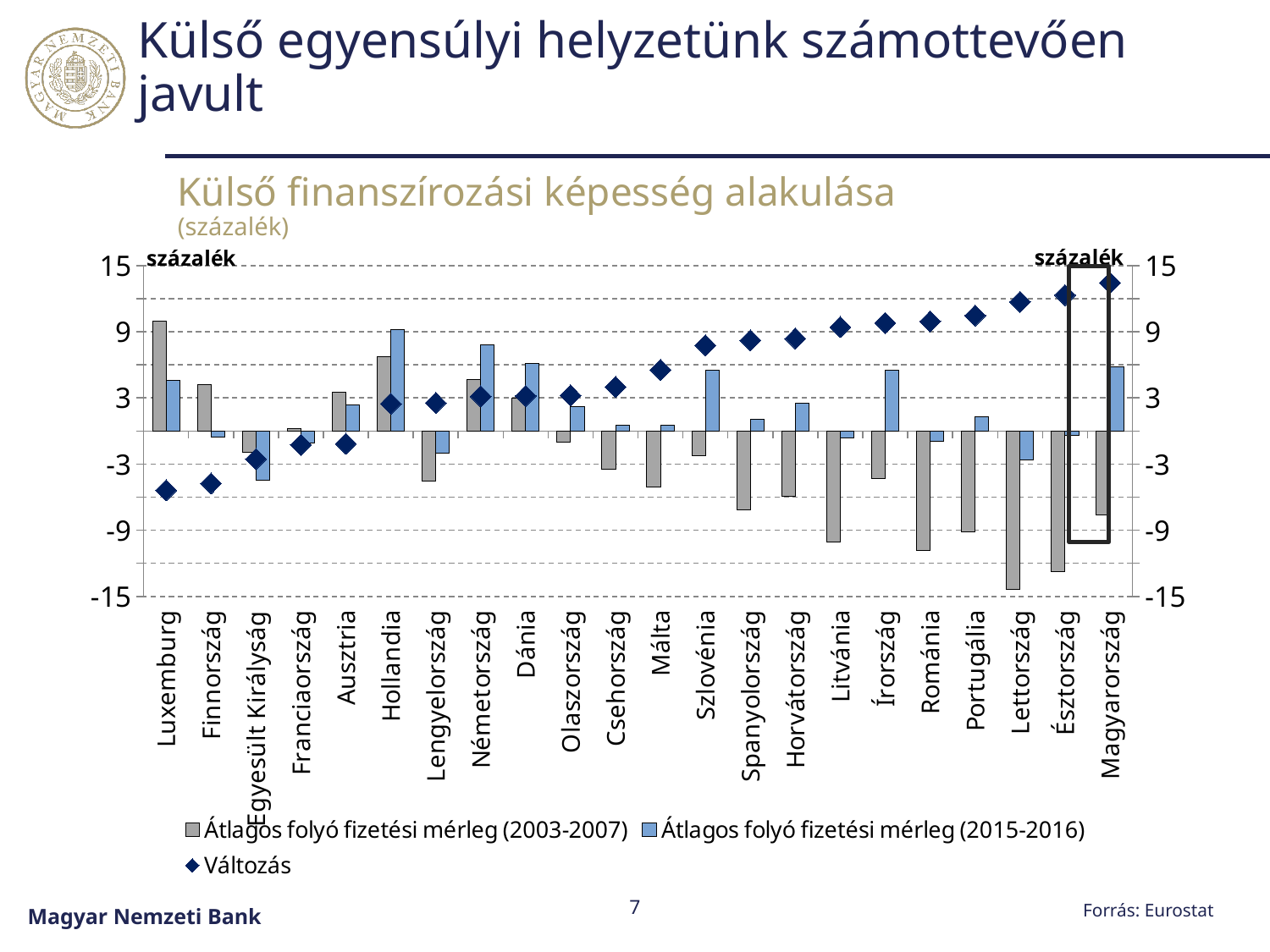
How many countries are shown on the x axis of the chart? 22 Is the Átlagos folyó fizetési mérleg (2003-2007) value for Lettország greater or less than -9? less For Magyarország, which is larger: the Átlagos folyó fizetési mérleg (2003-2007) or the Átlagos folyó fizetési mérleg (2015-2016)? Átlagos folyó fizetési mérleg (2015-2016) Which country has the lowest value for Átlagos folyó fizetési mérleg (2003-2007)? Lettország Is the Változás value for Magyarország greater or less than 9? greater What kind of chart is shown on the slide? bar chart How many series does the chart legend list? 3 Do the Változás values rise or fall moving from left to right along the x axis? rise Is the Átlagos folyó fizetési mérleg (2003-2007) value for Luxemburg greater or less than 9? greater Which country has the highest value for Átlagos folyó fizetési mérleg (2015-2016)? Hollandia Which country has the highest value for Átlagos folyó fizetési mérleg (2003-2007)? Luxemburg Which country has the highest Változás value? Magyarország